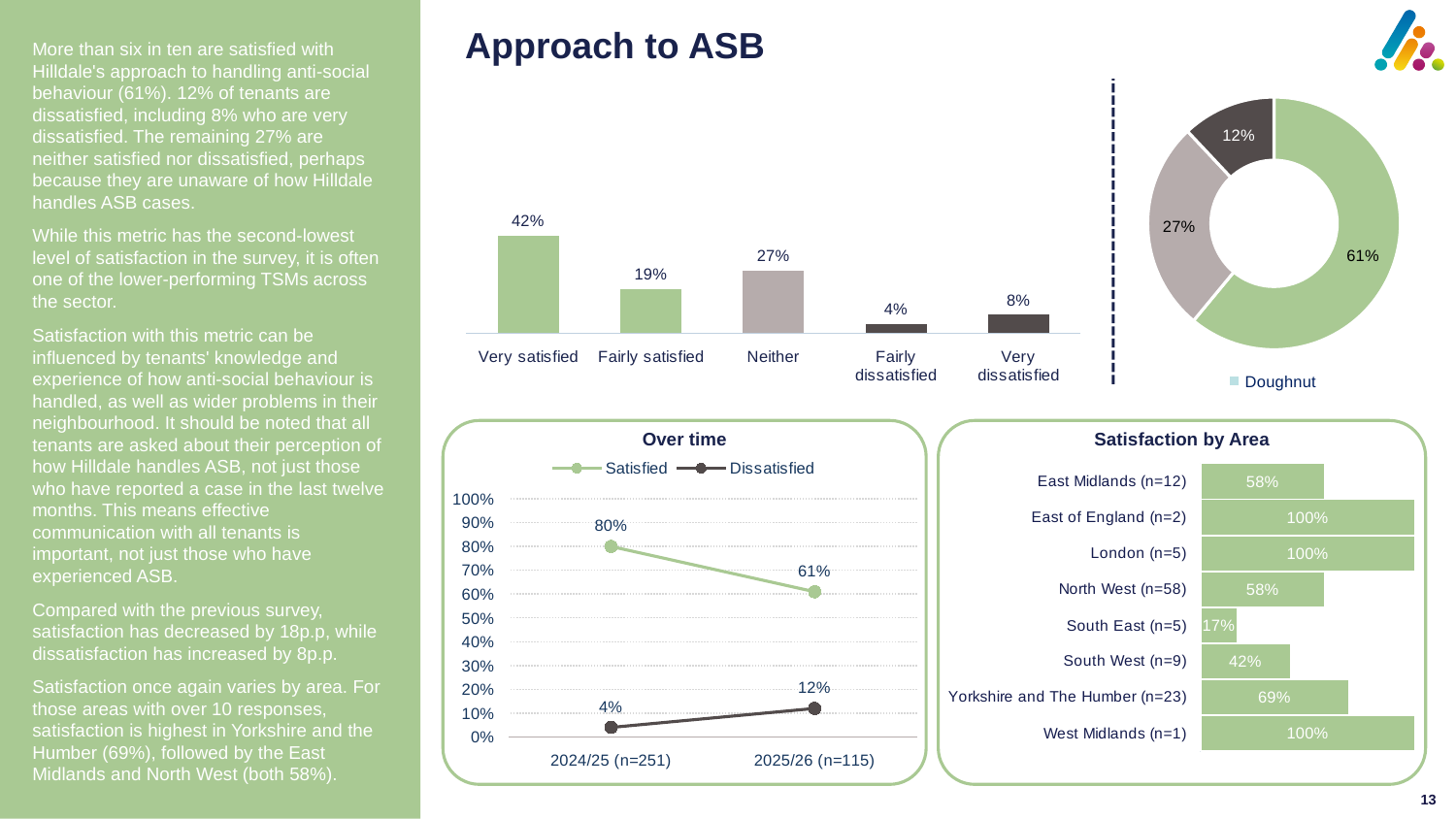
In the 'Over time' chart, does the Dissatisfied line rise or fall from 2024/25 to 2025/26? Rises In the 'Over time' chart, how many series does the legend list? 2 In the bar chart at the top of the slide, what percentage of tenants are very satisfied? 42% In the 'Satisfaction by Area' chart, which area has the lowest satisfaction? South East (n=5) In the bar chart at the top of the slide, what is the difference between the Very satisfied and Fairly satisfied values? 23 percentage points In the 'Over time' chart, what was the Satisfied value for 2024/25 (n=251)? 80% In the 'Satisfaction by Area' chart, is the value for North West (n=58) or South West (n=9) larger? North West (n=58) What type of chart is shown at the top right of the slide? Doughnut chart In the 'Satisfaction by Area' chart, what is the value for Yorkshire and The Humber (n=23)? 69% In the doughnut chart at the top right, what is the largest slice's value? 61% How many categories are shown in the bar chart at the top of the slide? 5 In the bar chart at the top of the slide, which category has the lowest value? Fairly dissatisfied